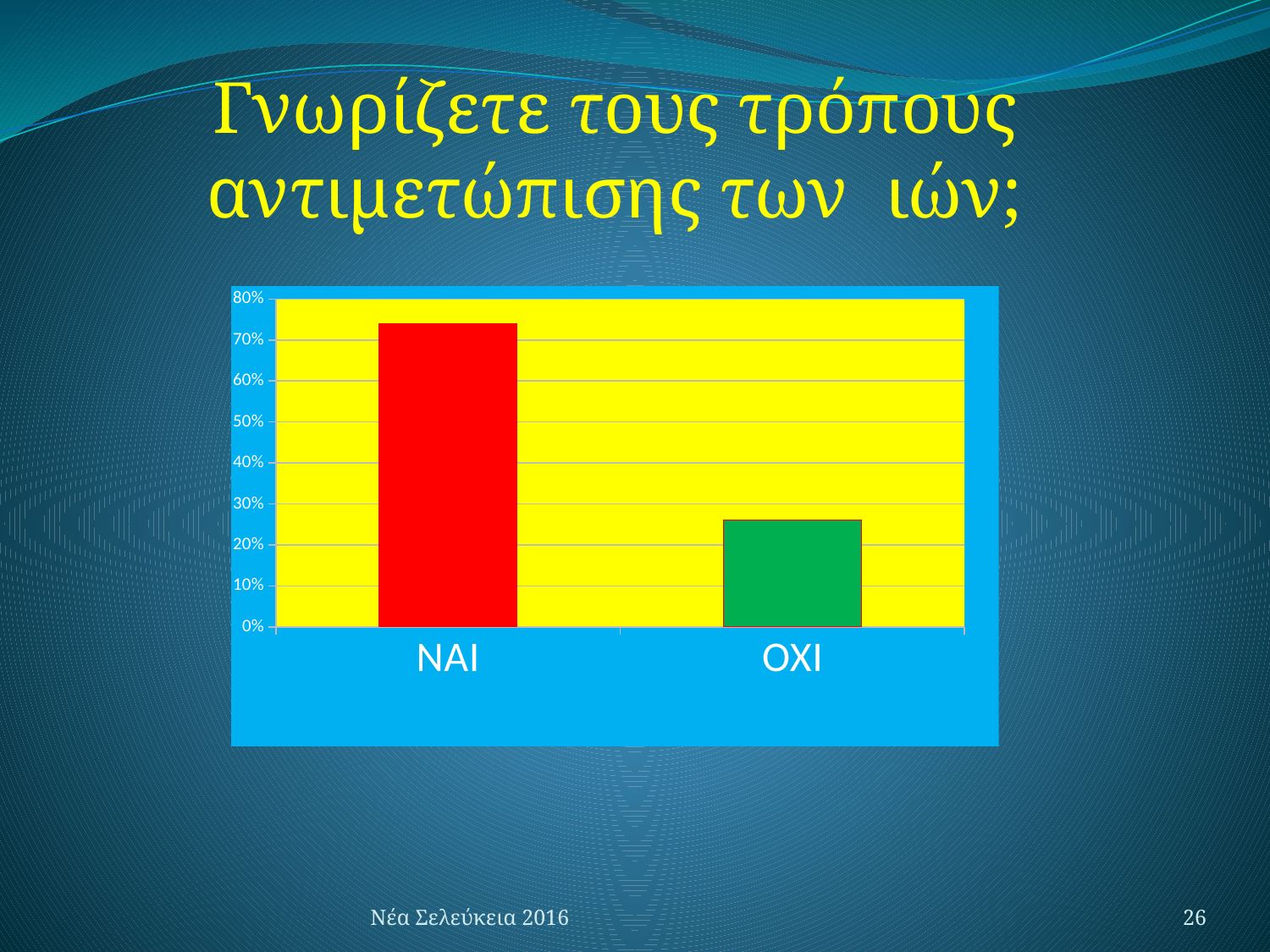
Which is larger, the value for ΝΑΙ or the value for ΟΧΙ? ΝΑΙ What kind of chart is shown on the slide? bar chart What colour is the bar for ΟΧΙ? green Which category has the highest bar in the chart? ΝΑΙ How many categories are shown on the x axis of the chart? 2 Which category has the lowest bar in the chart? ΟΧΙ What is the title of the slide above the chart? Γνωρίζετε τους τρόπους αντιμετώπισης των ιών; Do the values rise or fall from ΝΑΙ to ΟΧΙ along the x axis? fall Is the value for ΝΑΙ greater or less than 80%? less Is the value for ΝΑΙ greater or less than 70%? greater Is the value for ΟΧΙ greater or less than 30%? less